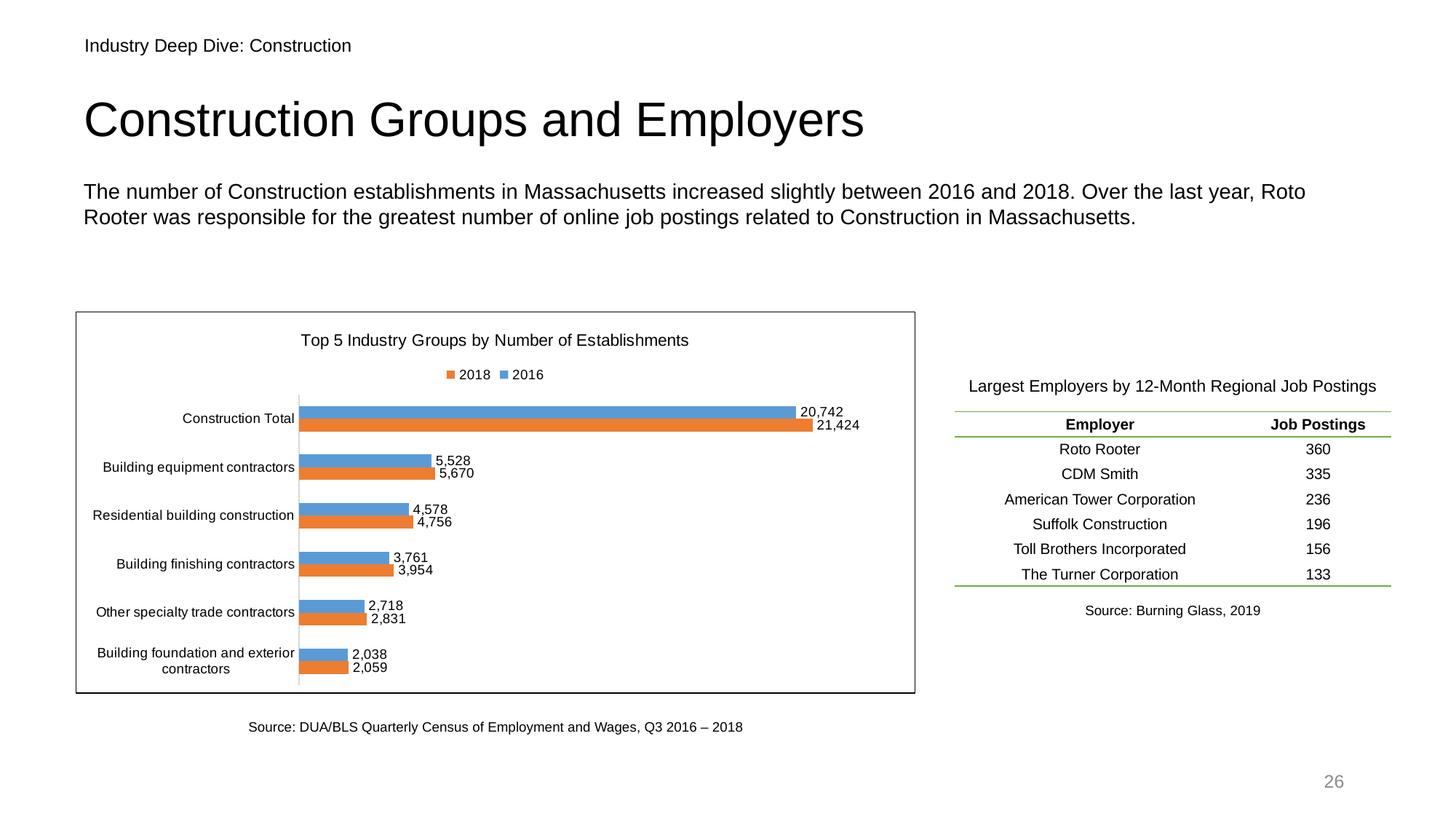
What is the 2016 value for Building foundation and exterior contractors? 2,038 What type of chart is shown on the slide? Bar chart Excluding Construction Total, which category has the lowest 2018 value? Building foundation and exterior contractors Excluding Construction Total, which category has the highest 2016 value? Building equipment contractors What is the 2018 value for Residential building construction? 4,756 How many categories are shown on the chart? 6 What is the title of the chart? Top 5 Industry Groups by Number of Establishments What is the difference between the 2018 and 2016 values for Construction Total? 682 How many series does the chart's legend list? 2 Which is larger for Building finishing contractors, the 2018 value or the 2016 value? 2018 What is the 2018 value for Construction Total? 21,424 What is the 2016 value for Building equipment contractors? 5,528